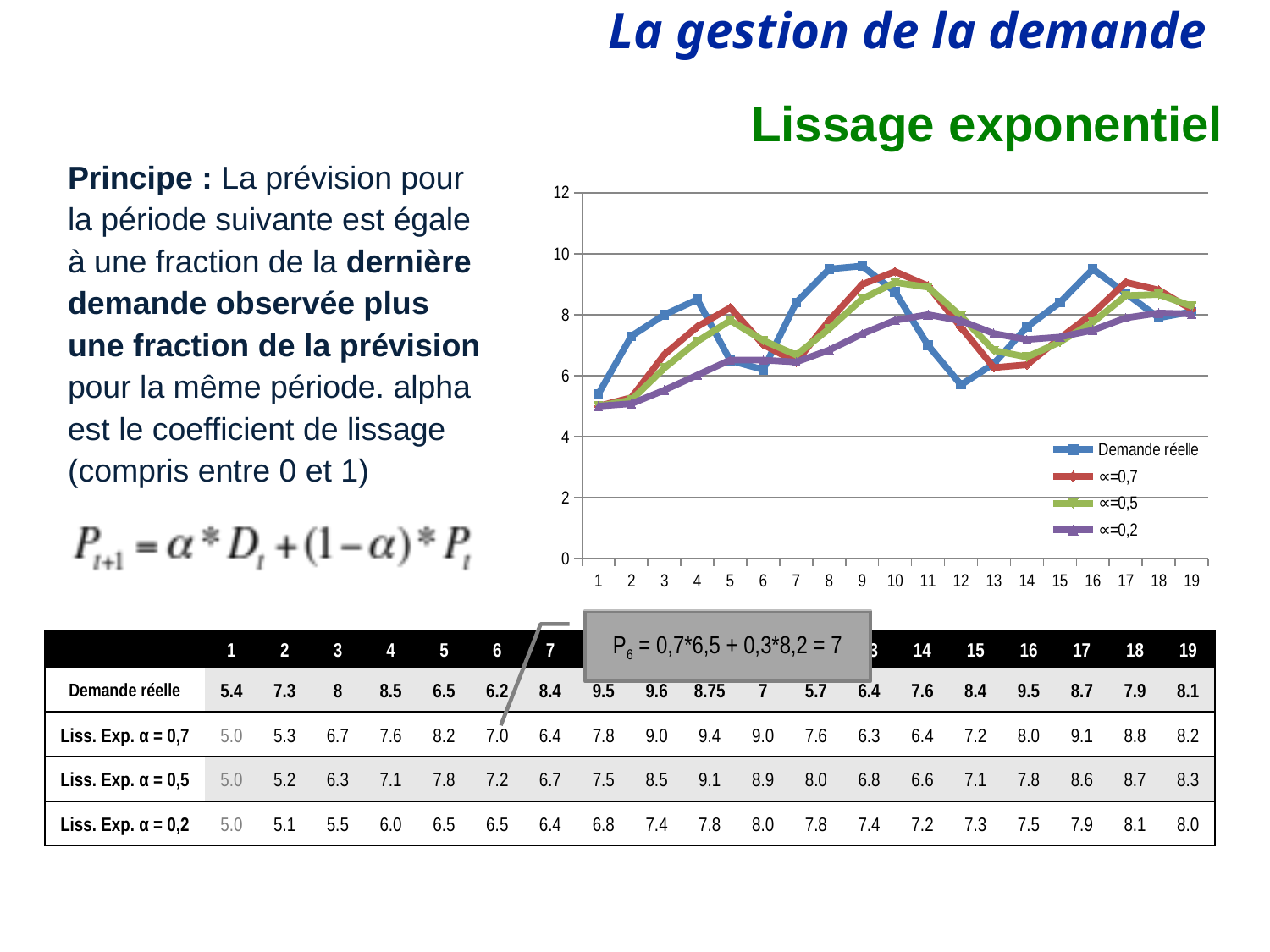
What is the difference between Demande réelle at period 2 and at period 1? 1.9 At period 12, which is larger: Demande réelle or the α = 0,2 series? α = 0,2 How many periods are plotted along the x axis of the chart? 19 At which period does the α = 0,7 series reach its highest value? 10 What is the value of the α = 0,2 series at period 11? 8.0 Does Demande réelle rise or fall from period 1 to period 4? rise What is the value of the α = 0,7 series at period 6? 7.0 What is the value of Demande réelle at period 9? 9.6 What kind of chart is shown on the slide? line chart How many series does the chart legend list? 4 At which period is Demande réelle at its lowest value? 1 Is the value of Demande réelle at period 12 greater or less than 6? less